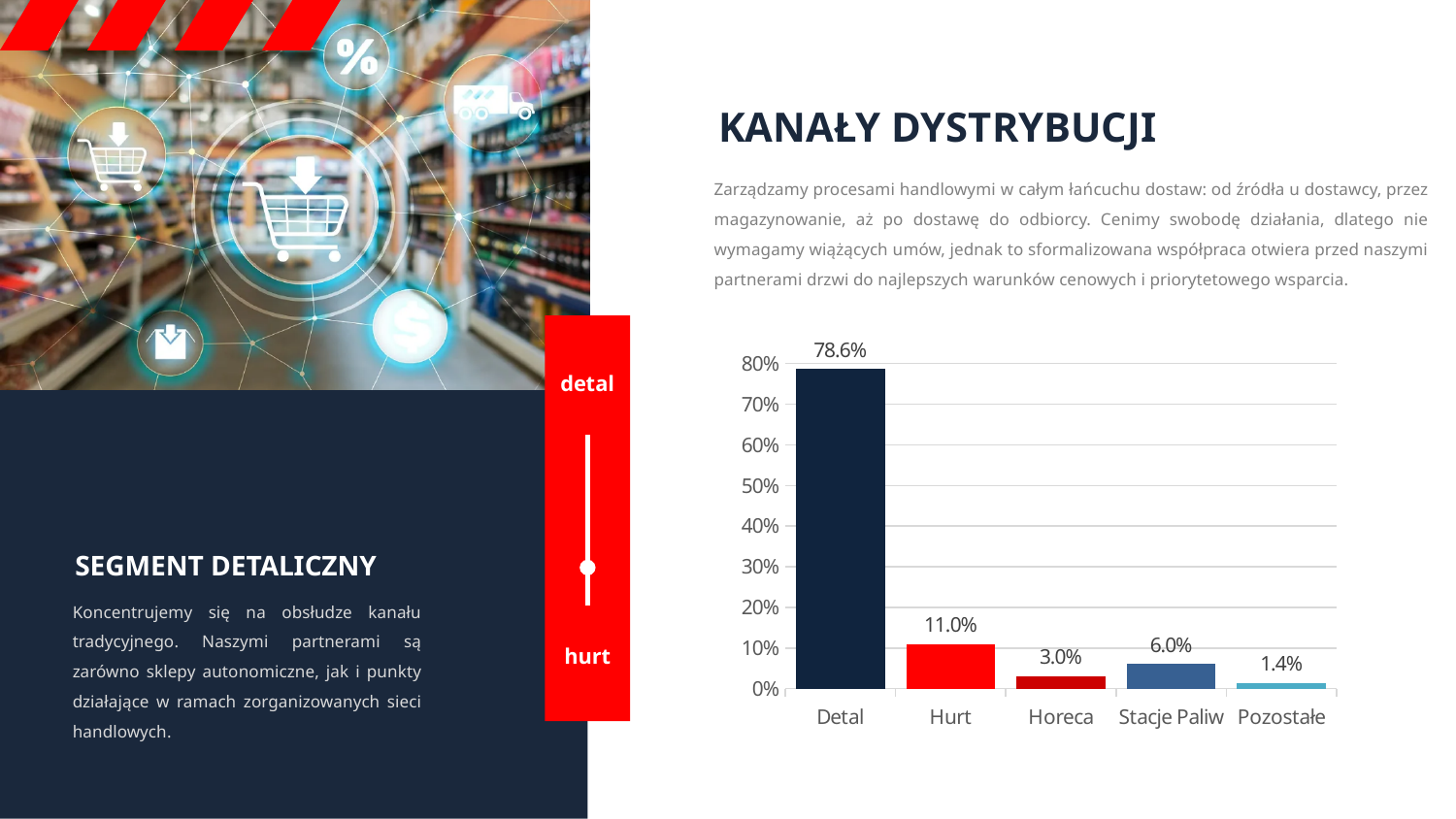
What is the value for Pozostałe? 1.4% Which category has the highest value? Detal What is the value for Detal? 78.6% What is the value for Horeca? 3.0% What kind of chart is shown on the slide? bar chart What is the difference between the values for Detal and Hurt? 67.6% Which is larger, the value for Stacje Paliw or the value for Horeca? Stacje Paliw Is the value for Detal greater or less than 70%? greater How many categories are shown on the x axis of the chart? 5 Which category has the lowest value? Pozostałe What is the value for Hurt? 11.0% What is the value for Stacje Paliw? 6.0%